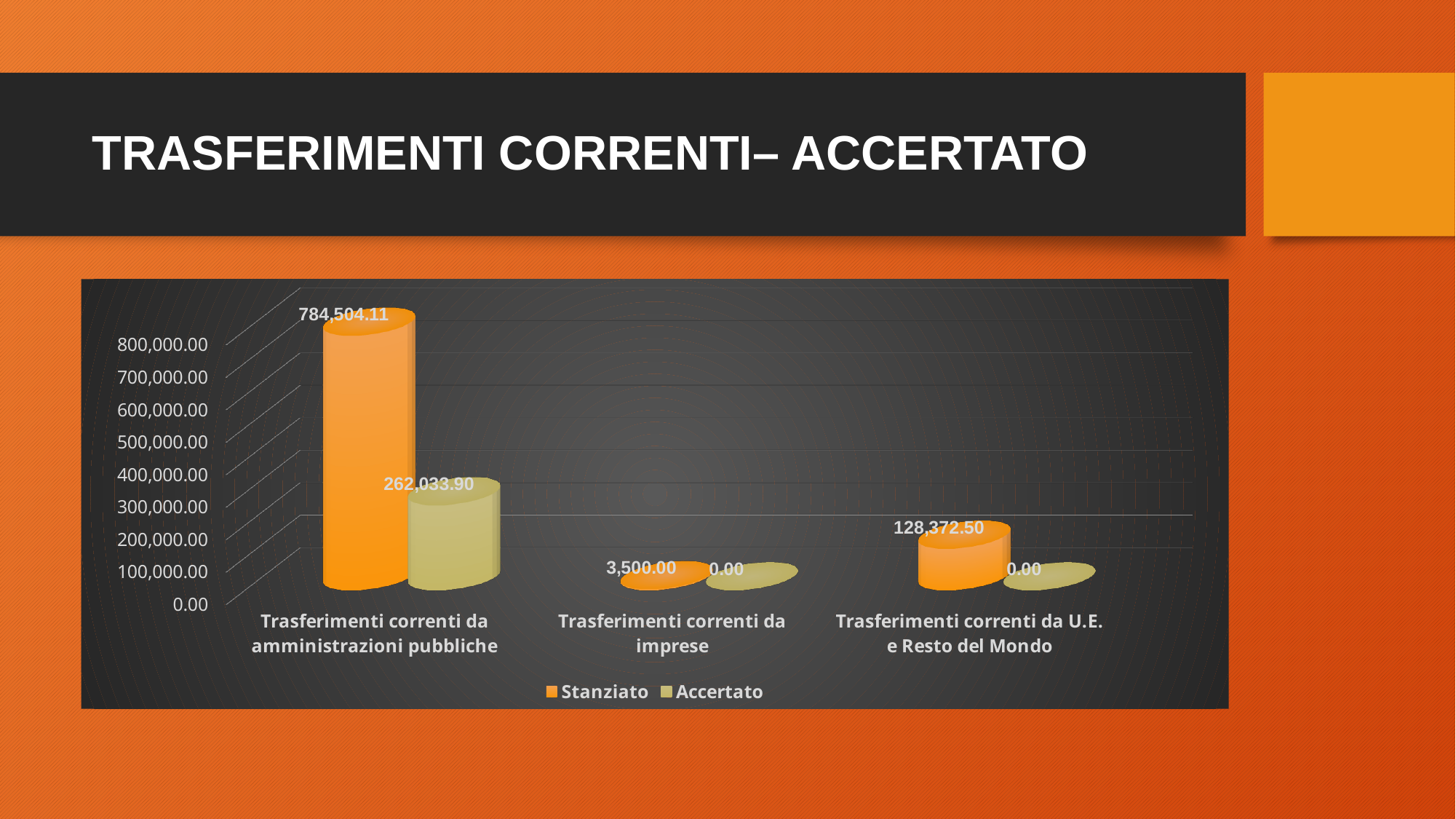
What is the Stanziato value for Trasferimenti correnti da imprese? 3,500.00 What is the Stanziato value for Trasferimenti correnti da amministrazioni pubbliche? 784,504.11 How many categories are shown on the x axis of the chart? 3 What is the difference between the Stanziato and Accertato values for Trasferimenti correnti da amministrazioni pubbliche? 522,470.21 What is the Stanziato value for Trasferimenti correnti da U.E. e Resto del Mondo? 128,372.50 Which is larger: the Stanziato value for Trasferimenti correnti da imprese or the Stanziato value for Trasferimenti correnti da U.E. e Resto del Mondo? Trasferimenti correnti da U.E. e Resto del Mondo Which category has the highest Stanziato value? Trasferimenti correnti da amministrazioni pubbliche Which category has the lowest Stanziato value? Trasferimenti correnti da imprese What is the Accertato value for Trasferimenti correnti da amministrazioni pubbliche? 262,033.90 How many series does the chart legend list? 2 What is the difference between the Stanziato values for Trasferimenti correnti da U.E. e Resto del Mondo and Trasferimenti correnti da imprese? 124,872.50 What is the Accertato value for Trasferimenti correnti da U.E. e Resto del Mondo? 0.00